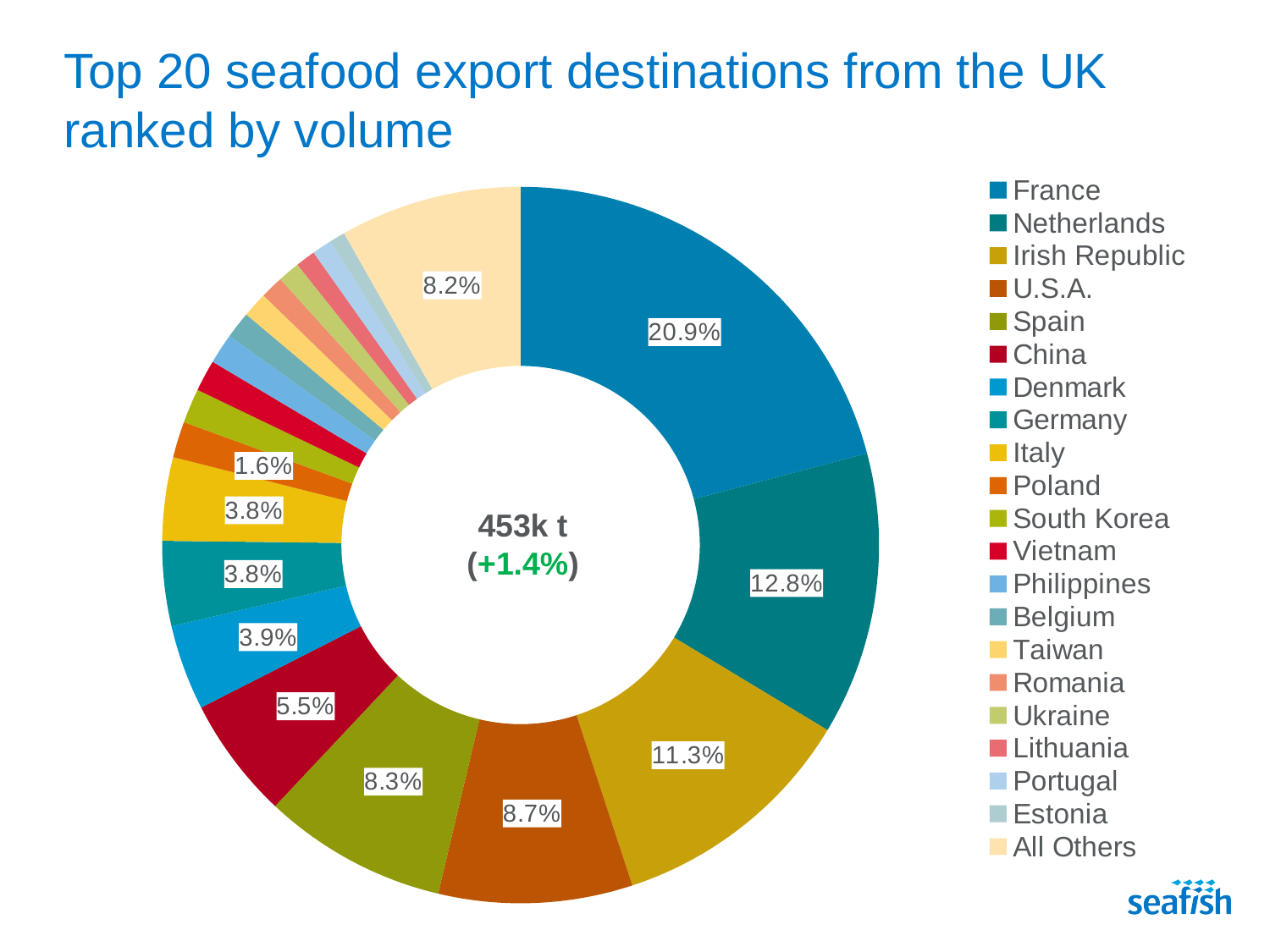
Which destination has the largest share of UK seafood export volume? France What share of UK seafood export volume goes to the Irish Republic? 11.3% What share of UK seafood export volume goes to France? 20.9% Which has the larger share, Spain or the U.S.A.? U.S.A. What kind of chart is shown on the slide? Pie chart (doughnut) What share is labelled for All Others? 8.2% What share of UK seafood export volume goes to the Netherlands? 12.8% What is the difference between the shares for France and the Netherlands? 8.1% What share is labelled for China? 5.5% How many entries does the legend list? 21 What share of UK seafood export volume goes to the U.S.A.? 8.7% What total volume is shown in the centre of the chart? 453k t